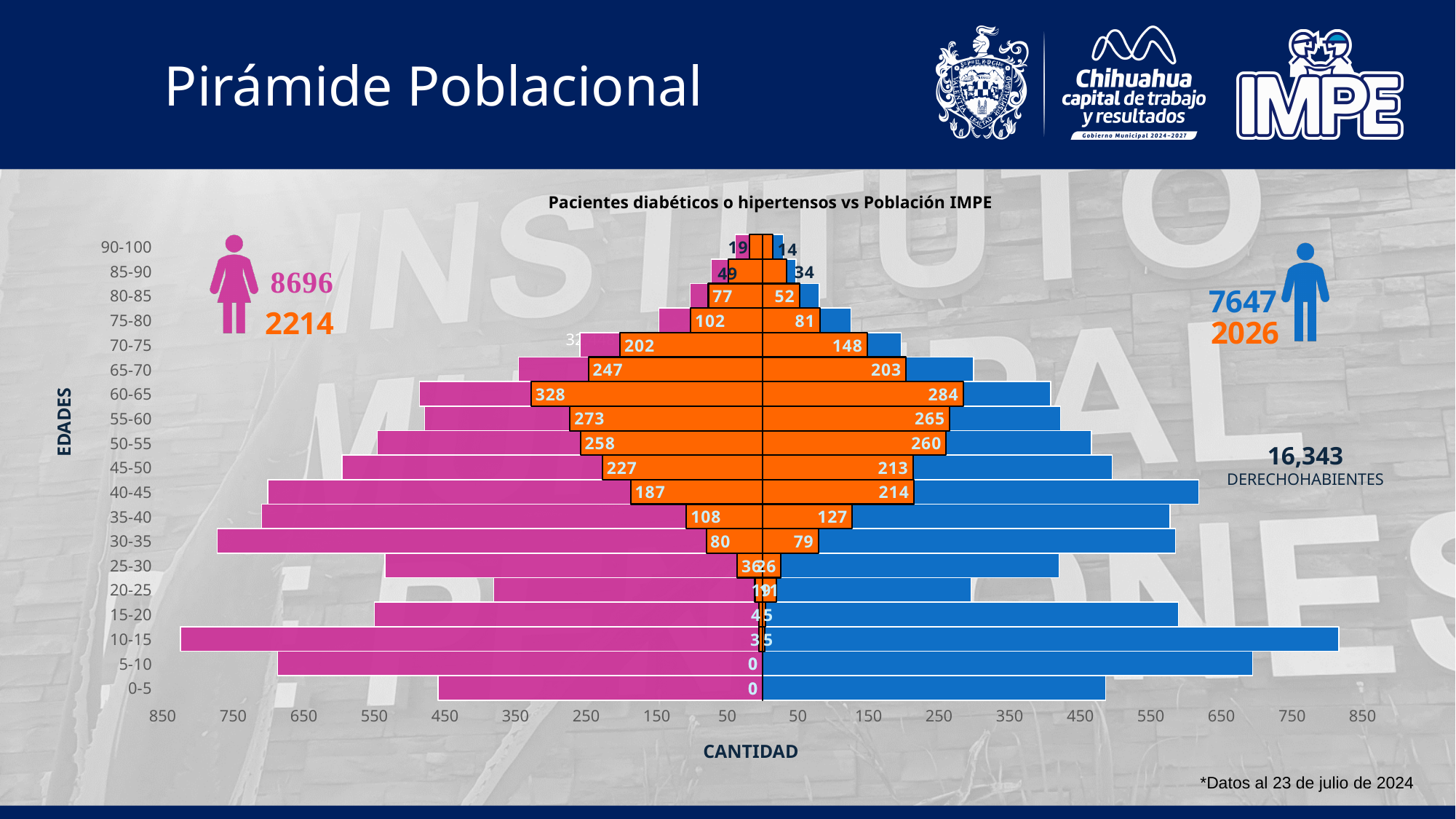
How many age groups are shown on the vertical axis of the chart? 19 In the 50-55 age group, are there more female patients or male patients (orange bars)? Male patients (260 vs 258) What is the title of the chart? Pacientes diabéticos o hipertensos vs Población IMPE Is the male population bar (blue) for the 40-45 age group greater or less than 550? greater What total number of female patients (orange) is shown next to the female icon on the left of the chart? 2214 Which age group has the highest number of female patients (orange bars on the left)? 60-65 Is the female population bar (pink) for the 10-15 age group greater or less than 750? greater Which age group has the highest number of male patients (orange bars on the right)? 60-65 What kind of chart is shown on the slide? Bar chart (population pyramid) What is the number of female diabetic or hypertensive patients (orange bar, left side) in the 60-65 age group? 328 What is the difference between female patients (328) and male patients (284) in the 60-65 age group? 44 What is the number of male diabetic or hypertensive patients (orange bar, right side) in the 40-45 age group? 214